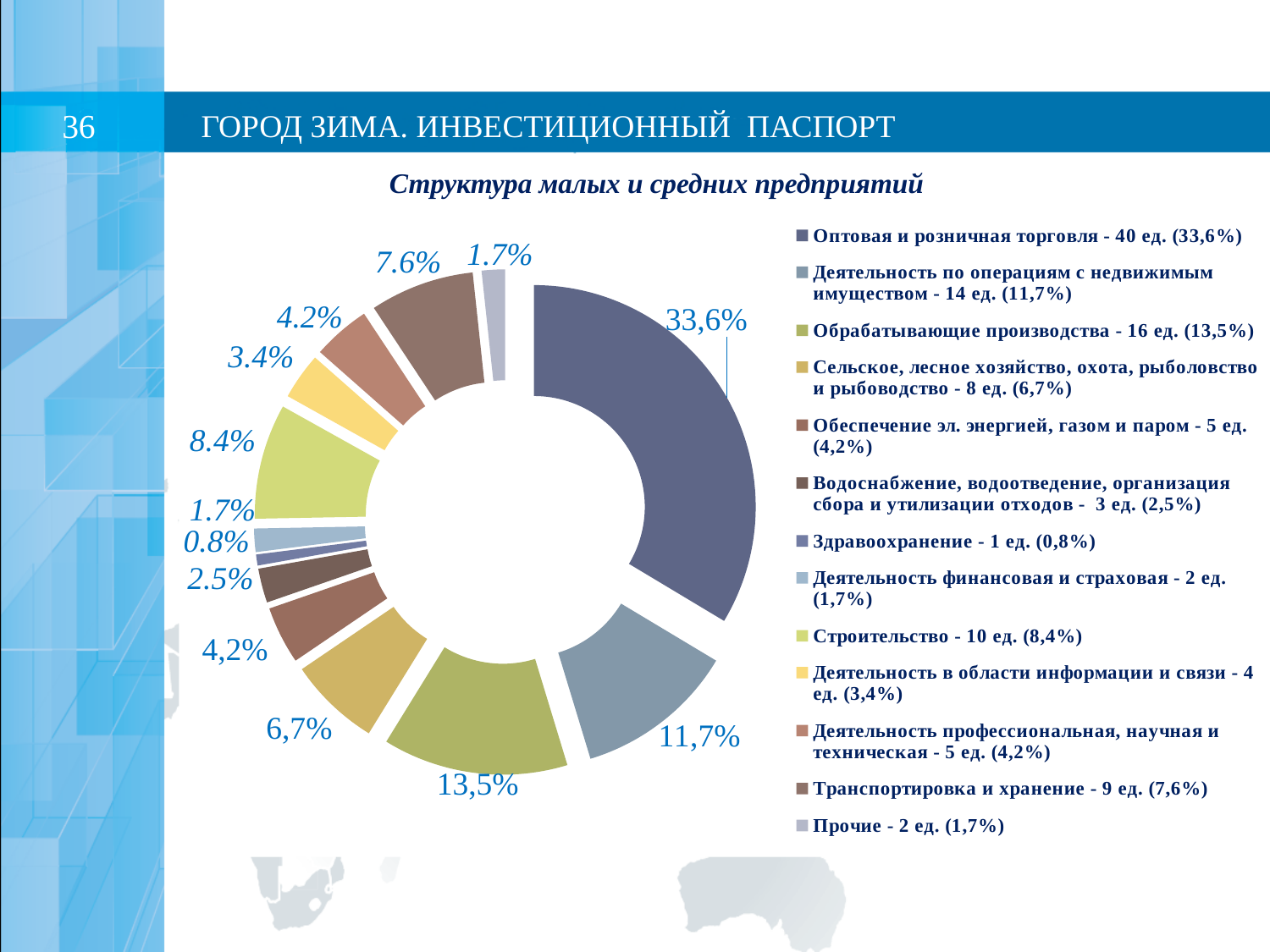
What is the difference in percentage points between Оптовая и розничная торговля (33,6%) and Деятельность по операциям с недвижимым имуществом (11,7%)? 21,9 What percentage is shown for Обрабатывающие производства? 13,5% How many enterprises (ед.) does the legend give for Транспортировка и хранение? 9 Which category has the smallest share of the pie? Здравоохранение What is the title of the chart? Структура малых и средних предприятий How many enterprises (ед.) does the legend give for Строительство? 10 How many categories does the legend list? 13 Which is larger: the share of Обрабатывающие производства or the share of Деятельность по операциям с недвижимым имуществом? Обрабатывающие производства What share of the pie does Оптовая и розничная торговля have? 33,6% Which category has the largest share of the pie? Оптовая и розничная торговля What kind of chart is shown on the slide? Doughnut (ring) chart How many more enterprises are in Оптовая и розничная торговля (40 ед.) than in Обрабатывающие производства (16 ед.)? 24